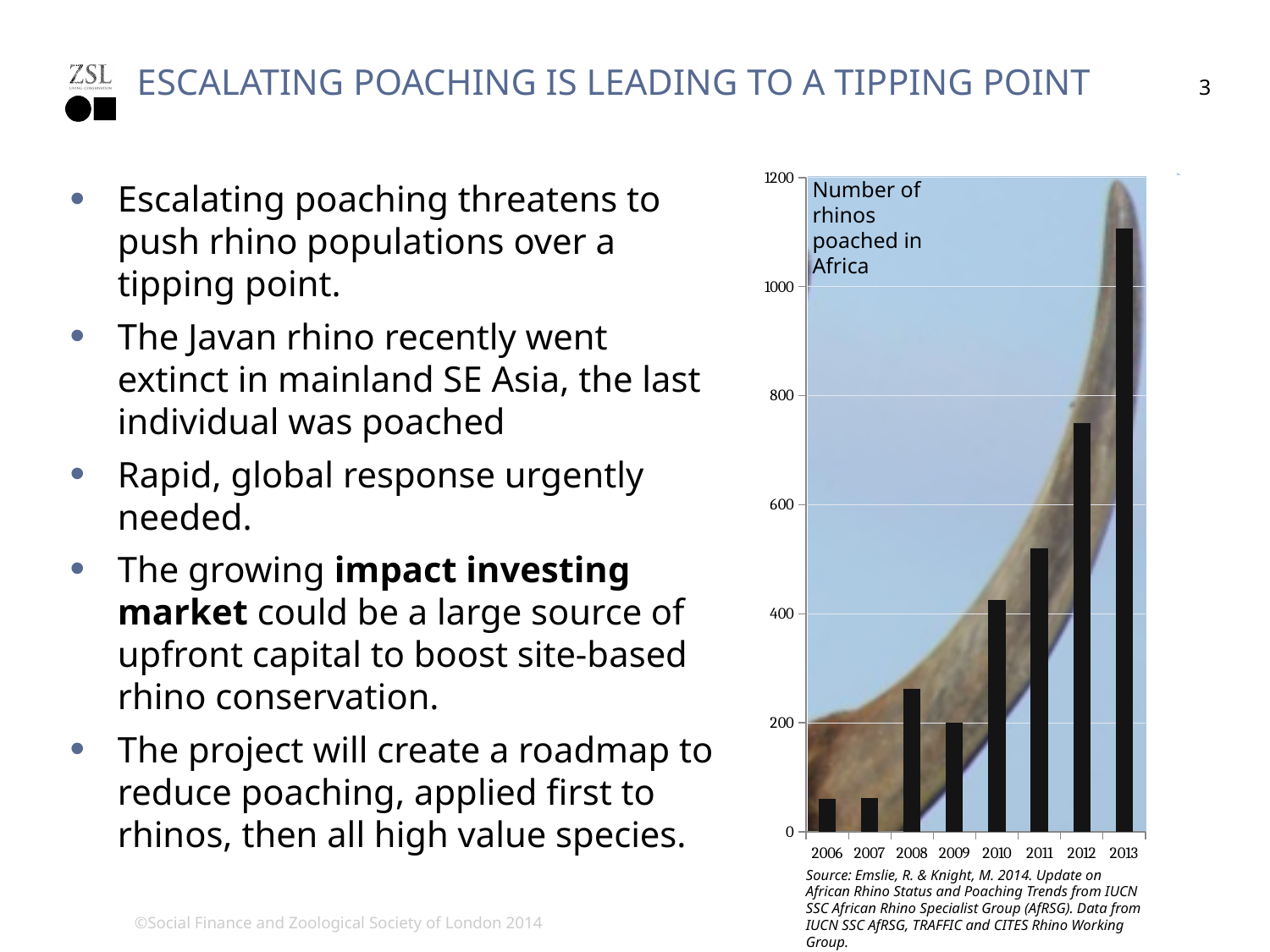
Is the value for 2013 greater or less than 1000? greater Is the value for 2012 greater or less than 600? greater Is the value for 2006 greater or less than 200? less Which year has the larger value, 2011 or 2012? 2012 Do the values generally rise or fall from 2006 to 2013? rise Which year has the highest number of rhinos poached in Africa? 2013 How many years are shown on the x axis of the chart? 8 What is the title of the chart? Number of rhinos poached in Africa What kind of chart is shown on the slide? bar chart